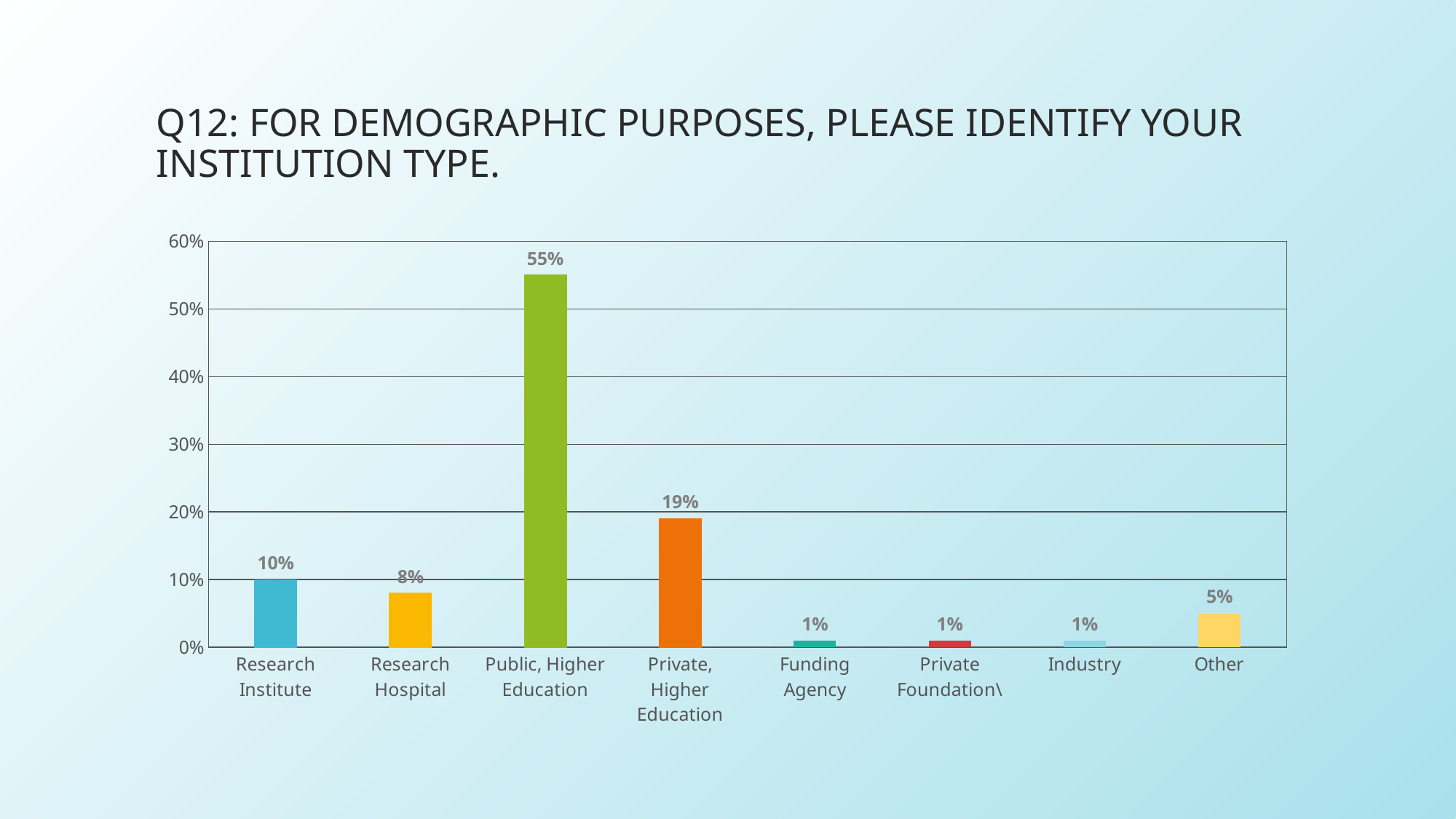
What percentage is shown for Private, Higher Education? 19% What is the value for the Other category? 5% What is the difference between the values for Research Institute and Research Hospital? 2% Which institution type has the highest percentage? Public, Higher Education What is the difference between the values for Public, Higher Education and Private, Higher Education? 36% What is the highest value shown on the y axis? 60% What kind of chart is shown on the slide? Bar chart What is the value shown for Research Hospital? 8% Which is larger, the value for Research Institute or the value for Other? Research Institute What percentage of respondents identified their institution type as Public, Higher Education? 55% Is the value for Private, Higher Education greater or less than 20%? less How many institution type categories are shown on the x axis? 8